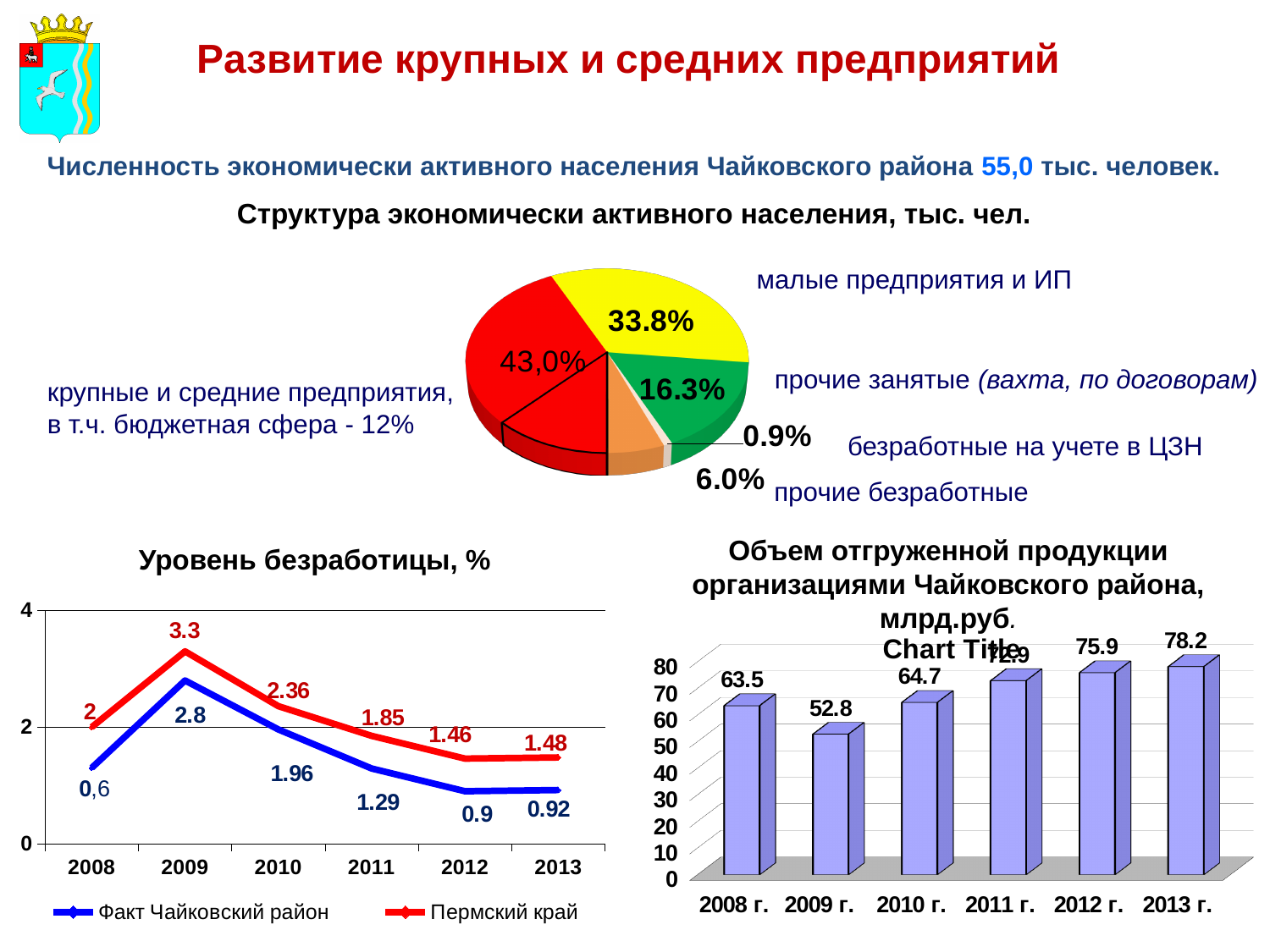
In the pie chart 'Структура экономически активного населения', which category has the smallest slice? безработные на учете в ЦЗН In the chart 'Уровень безработицы, %', what is the value for Факт Чайковский район in 2011? 1.29 In the chart 'Объем отгруженной продукции организациями Чайковского района', which year has the highest value? 2013 г. In the chart 'Объем отгруженной продукции организациями Чайковского района', what is the value for 2009 г.? 52.8 How many slices does the pie chart 'Структура экономически активного населения' have? 6 In the chart 'Уровень безработицы, %', how many series does the legend list? 2 In the chart 'Уровень безработицы, %', do the values for Факт Чайковский район rise or fall from 2009 to 2012? fall In the pie chart 'Структура экономически активного населения', what share is labelled for прочие занятые? 16.3% In the chart 'Уровень безработицы, %', what is the value for Пермский край in 2009? 3.3 In the pie chart 'Структура экономически активного населения', what share is labelled for малые предприятия и ИП? 33.8% What kind of chart is 'Объем отгруженной продукции организациями Чайковского района'? bar chart In the chart 'Уровень безработицы, %', what is the difference between Пермский край and Факт Чайковский район in 2012? 0.56